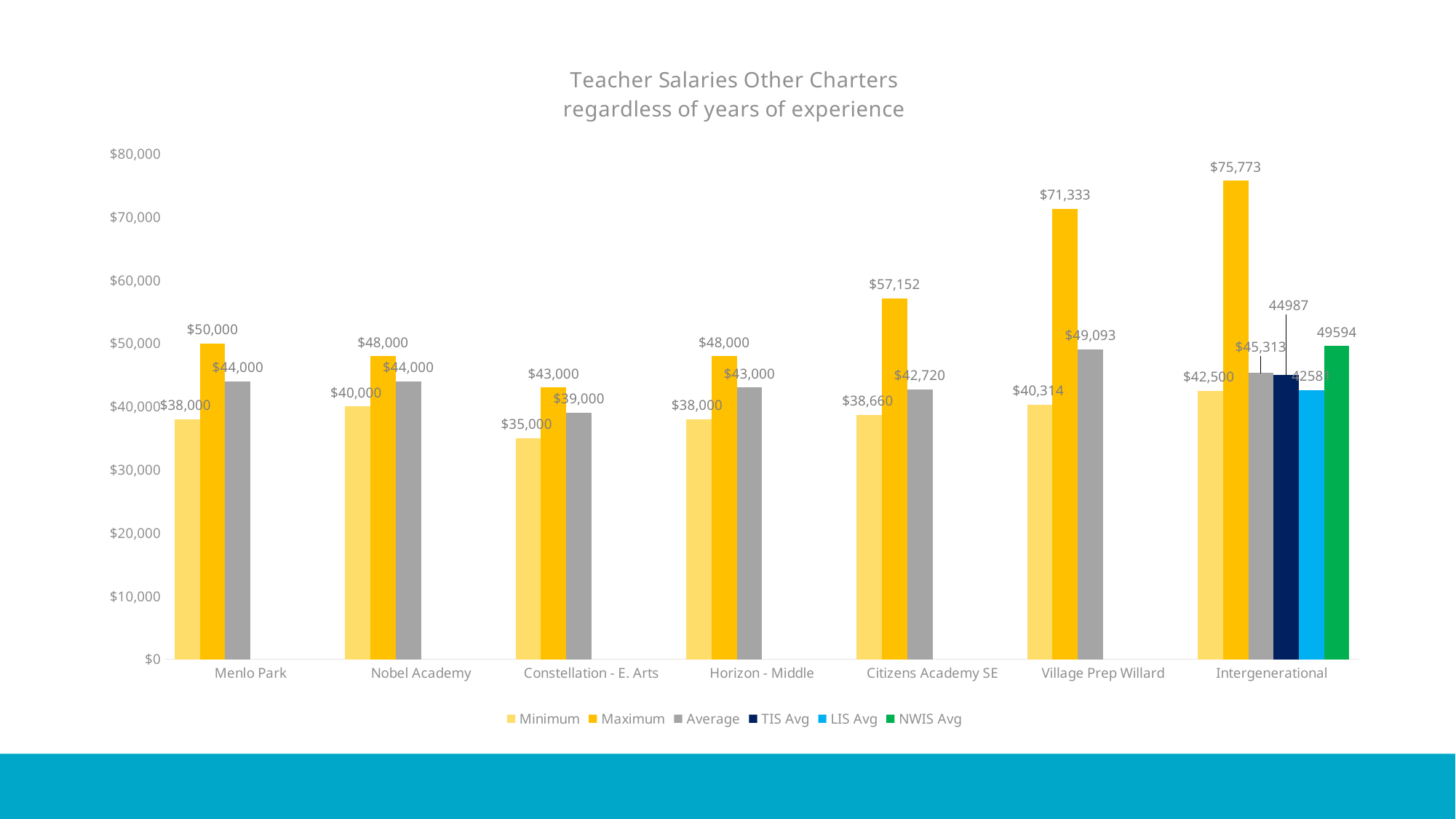
Which school has the lowest Minimum salary? Constellation - E. Arts What is the Average salary for Citizens Academy SE? $42,720 How many series does the legend list? 6 What is the Maximum salary for Village Prep Willard? $71,333 What kind of chart is shown on the slide? bar chart What is the title of the chart? Teacher Salaries Other Charters regardless of years of experience What is the NWIS Avg value shown for Intergenerational? 49594 How many schools (categories) are shown along the x axis? 7 What is the difference between the Maximum and Minimum salary for Menlo Park? $12,000 Is the Maximum salary for Intergenerational greater or less than $70,000? greater Which is larger: the Maximum salary for Citizens Academy SE or the Maximum salary for Horizon - Middle? Citizens Academy SE Which school has the highest Maximum salary? Intergenerational